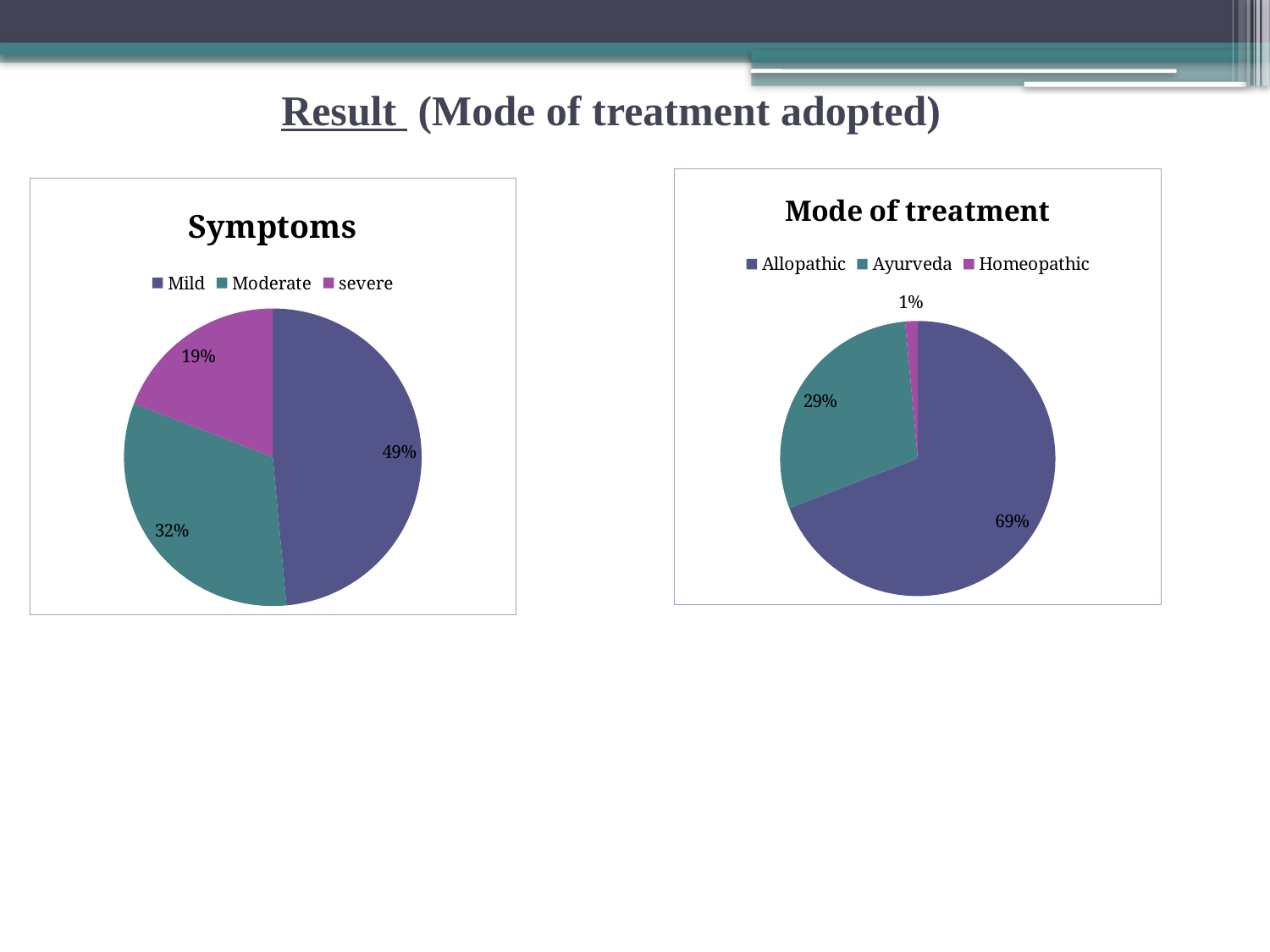
In the Symptoms chart, what share of the pie is severe? 19% In the Mode of treatment chart, what share of the pie is Homeopathic? 1% In the Symptoms chart, what is the difference between the Mild and severe shares? 30% In the Mode of treatment chart, what share of the pie is Allopathic? 69% In the Symptoms chart, which category has the largest slice? Mild What kind of chart is the Mode of treatment chart? Pie chart In the Mode of treatment chart, what is the difference between the Allopathic and Ayurveda shares? 40% In the Symptoms chart, which category has the smallest slice? severe In the Mode of treatment chart, which category has the smallest slice? Homeopathic